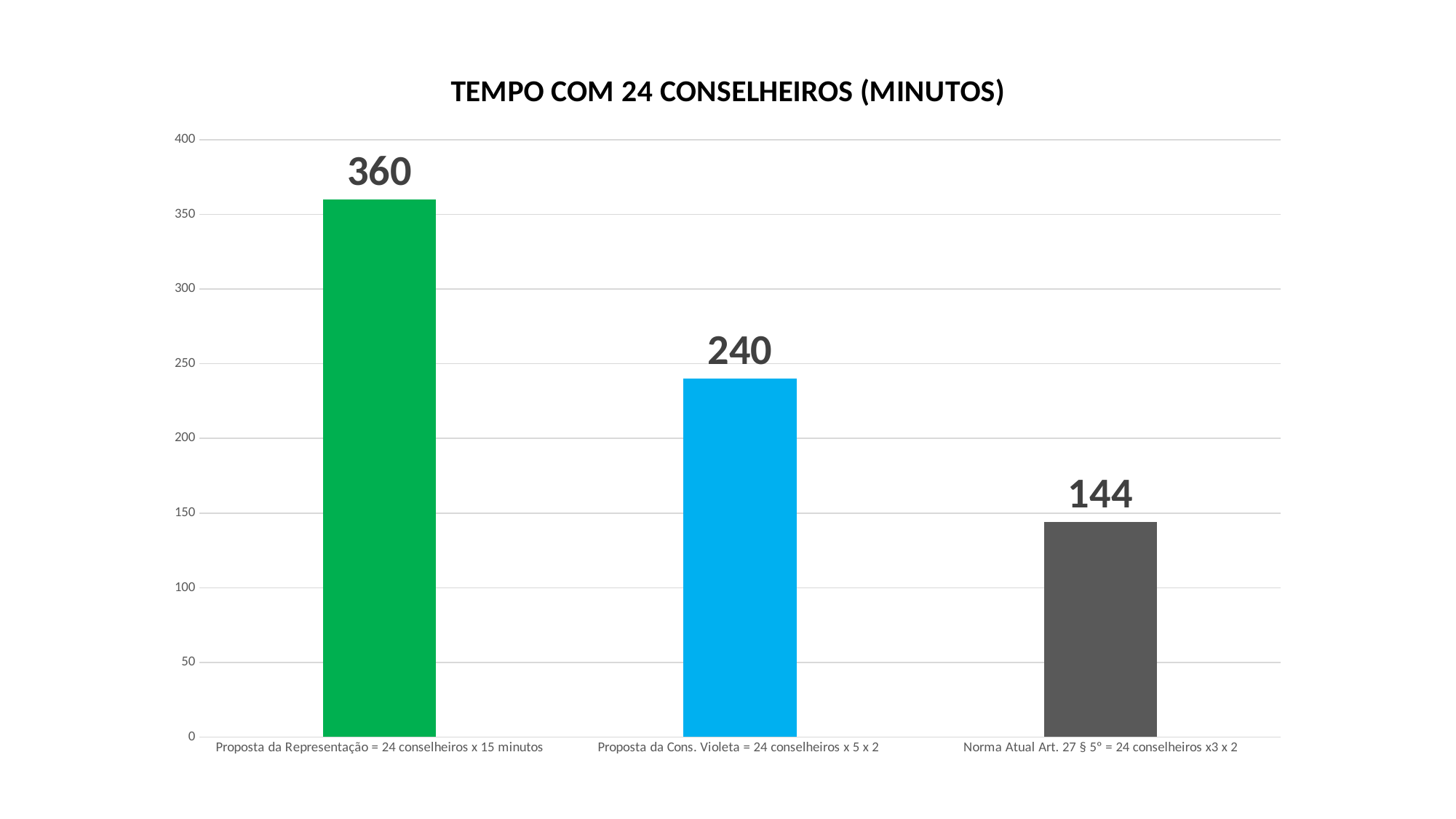
How many categories are shown in the chart? 3 What is the value for "Proposta da Representação = 24 conselheiros x 15 minutos"? 360 What is the value for "Proposta da Cons. Violeta = 24 conselheiros x 5 x 2"? 240 What is the title of the chart? TEMPO COM 24 CONSELHEIROS (MINUTOS) What is the difference between the values for "Proposta da Representação" and "Proposta da Cons. Violeta"? 120 What is the value for "Norma Atual Art. 27 § 5° = 24 conselheiros x3 x 2"? 144 Which category has the highest value? Proposta da Representação = 24 conselheiros x 15 minutos Which category has the lowest value? Norma Atual Art. 27 § 5° = 24 conselheiros x3 x 2 Is the value for "Norma Atual Art. 27 § 5°" greater or less than 150? less What is the difference between the values for "Proposta da Cons. Violeta" and "Norma Atual Art. 27 § 5°"? 96 Which is larger, the value for "Proposta da Cons. Violeta" or the value for "Norma Atual Art. 27 § 5°"? Proposta da Cons. Violeta What kind of chart is shown on the slide? bar chart